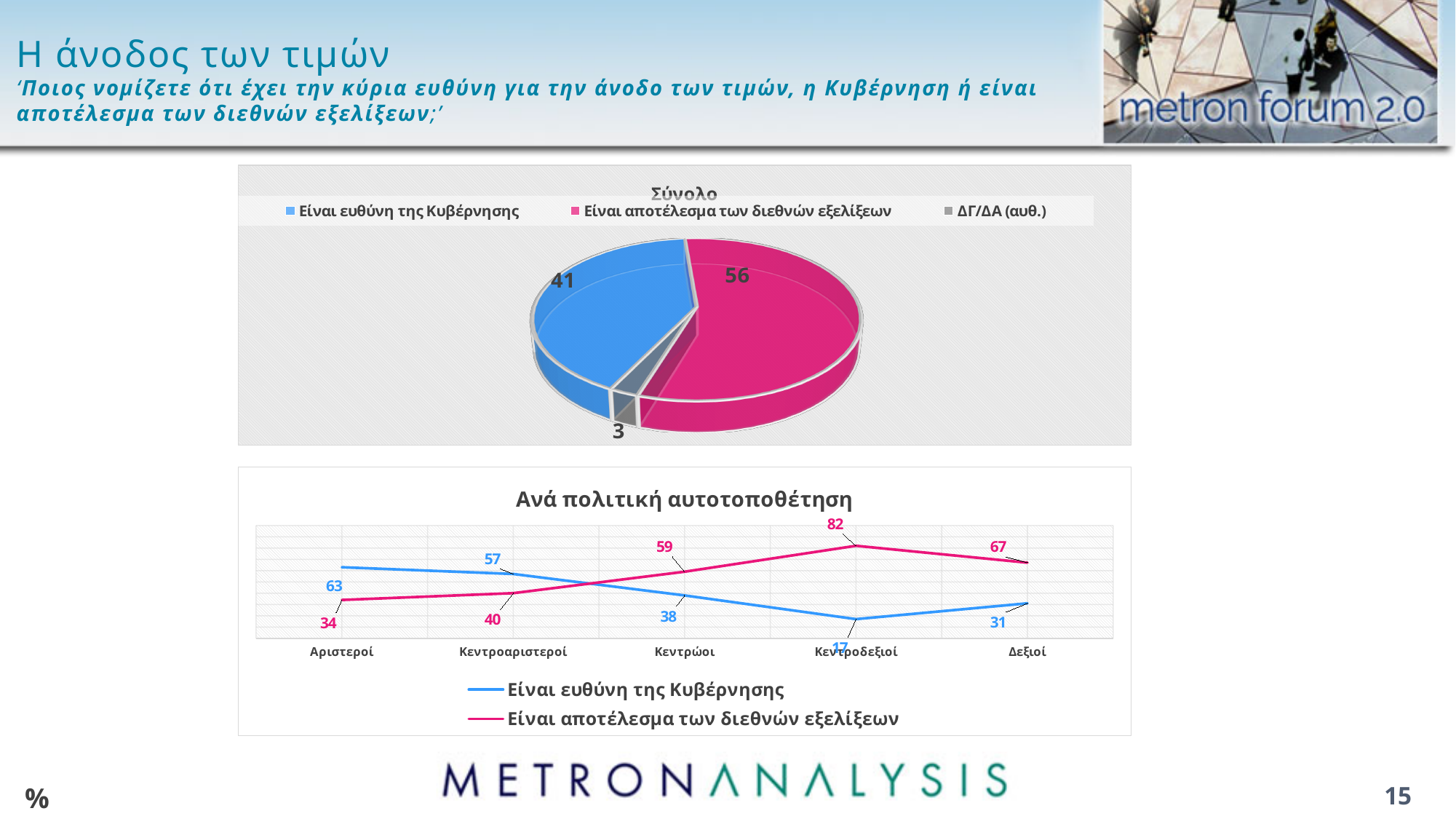
In the chart titled 'Ανά πολιτική αυτοτοποθέτηση', what is the value of 'Είναι αποτέλεσμα των διεθνών εξελίξεων' for 'Κεντροδεξιοί'? 82 In the chart titled 'Ανά πολιτική αυτοτοποθέτηση', for which category is 'Είναι ευθύνη της Κυβέρνησης' lowest? Κεντροδεξιοί In the chart titled 'Ανά πολιτική αυτοτοποθέτηση', what is the difference between the two series for 'Δεξιοί'? 36 In the pie chart titled 'Σύνολο', which category has the largest slice? Είναι αποτέλεσμα των διεθνών εξελίξεων In the chart titled 'Ανά πολιτική αυτοτοποθέτηση', which is larger for 'Κεντρώοι': 'Είναι ευθύνη της Κυβέρνησης' or 'Είναι αποτέλεσμα των διεθνών εξελίξεων'? Είναι αποτέλεσμα των διεθνών εξελίξεων In the chart titled 'Ανά πολιτική αυτοτοποθέτηση', what is the value of 'Είναι ευθύνη της Κυβέρνησης' for 'Αριστεροί'? 63 In the pie chart titled 'Σύνολο', what is the value for 'ΔΓ/ΔΑ (αυθ.)'? 3 In the pie chart titled 'Σύνολο', how many categories does the legend list? 3 What kind of chart is the chart titled 'Ανά πολιτική αυτοτοποθέτηση'? line chart In the pie chart titled 'Σύνολο', what is the difference between the values for 'Είναι αποτέλεσμα των διεθνών εξελίξεων' and 'Είναι ευθύνη της Κυβέρνησης'? 15 In the pie chart titled 'Σύνολο', what is the value for 'Είναι αποτέλεσμα των διεθνών εξελίξεων'? 56 In the chart titled 'Ανά πολιτική αυτοτοποθέτηση', how many categories are shown on the x axis? 5